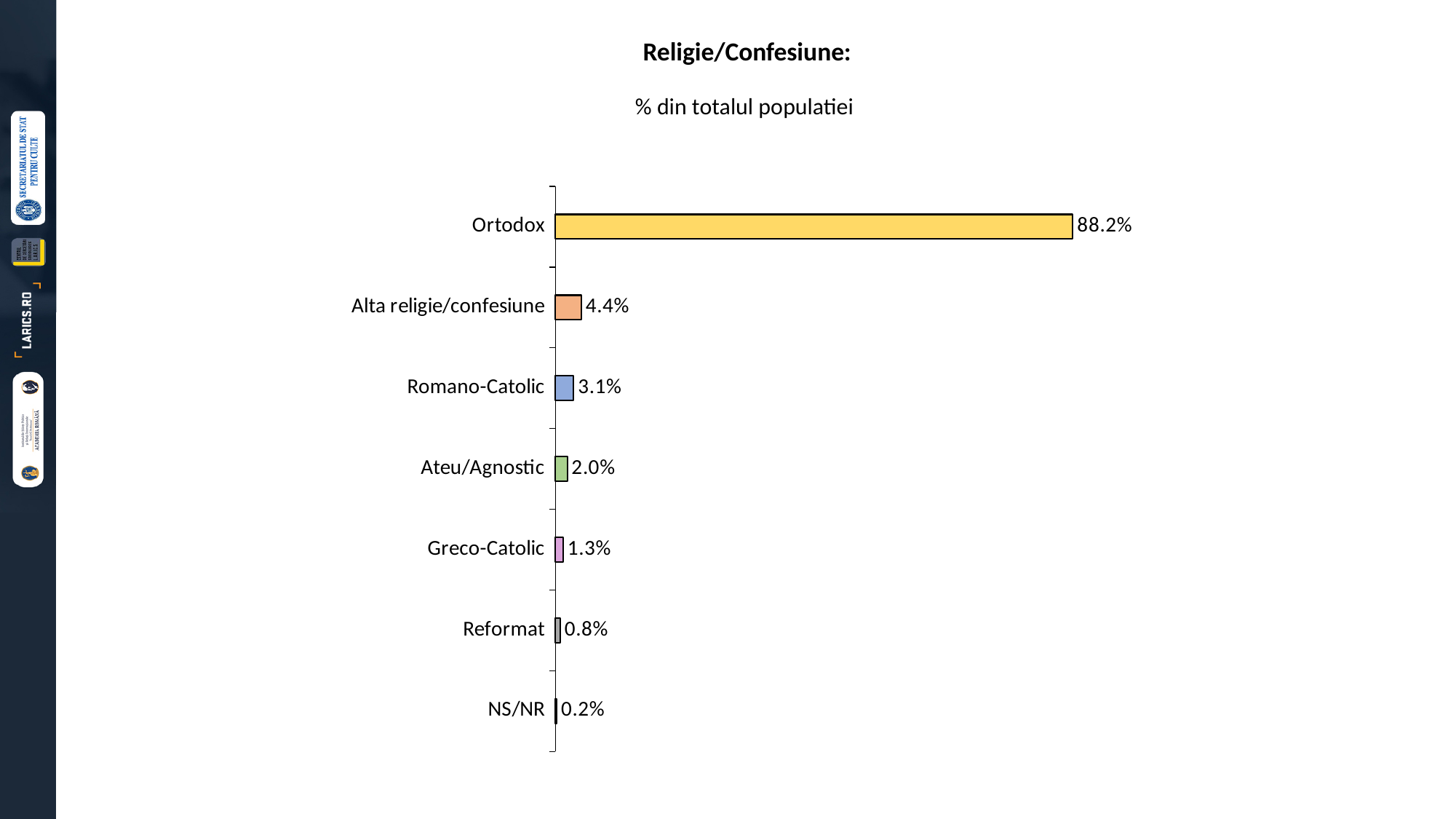
Which category has the highest value? Ortodox What is the title of the chart? Religie/Confesiune: What is the difference between the values for Alta religie/confesiune and Romano-Catolic? 1.3% What is the value shown for NS/NR? 0.2% How many categories are shown in the chart? 7 Which category has the lowest value? NS/NR What kind of chart is shown on the slide? Bar chart What is the value shown for Romano-Catolic? 3.1% What is the value shown for Greco-Catolic? 1.3% What percentage of the population is Ortodox? 88.2% Which is larger, the value for Greco-Catolic or the value for Reformat? Greco-Catolic What is the difference between the values for Ateu/Agnostic and Reformat? 1.2%